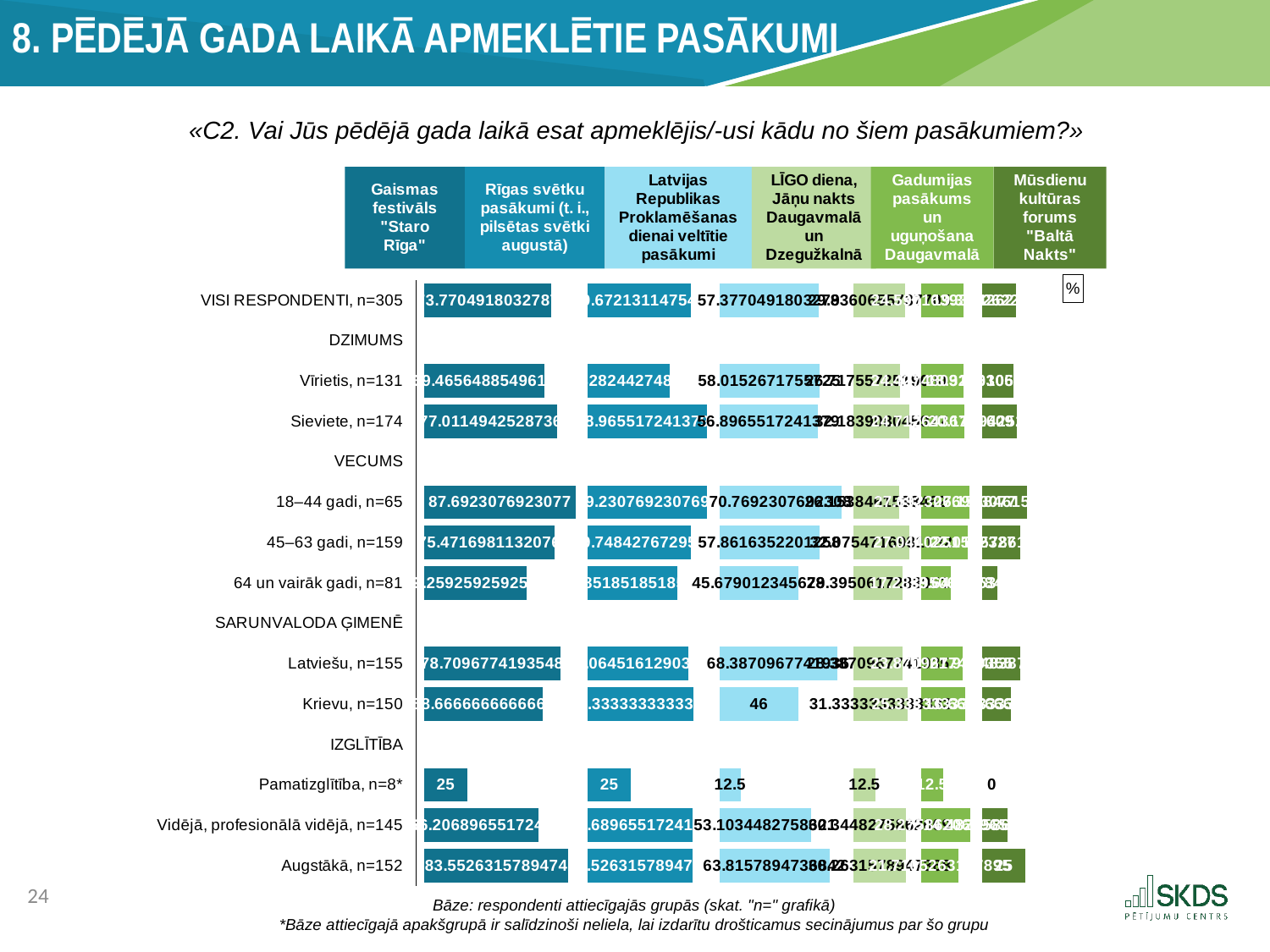
Which respondent group has the highest value for "Gaismas festivāls "Staro Rīga""? 18–44 gadi, n=65 What is the value for "Latvijas Republikas Proklamēšanas dienai veltītie pasākumi" in the "Krievu, n=150" row? 46 In the "Pamatizglītība, n=8*" row, which is larger: the value for "Gaismas festivāls "Staro Rīga"" or for "Latvijas Republikas Proklamēšanas dienai veltītie pasākumi"? Gaismas festivāls "Staro Rīga" How many respondent groups (rows with bars) are plotted in the chart? 11 Which respondent group has the lowest value for "Gaismas festivāls "Staro Rīga""? Pamatizglītība, n=8* What is the value for "Gaismas festivāls "Staro Rīga"" in the "Augstākā, n=152" row? 83.5526315789474 What is the value for "Mūsdienu kultūras forums "Baltā Nakts"" in the "Pamatizglītība, n=8*" row? 0 What is the value for "Gaismas festivāls "Staro Rīga"" in the "Pamatizglītība, n=8*" row? 25 What is the value for "Gaismas festivāls "Staro Rīga"" in the "18–44 gadi, n=65" row? 87.6923076923077 What kind of chart is shown on the slide? bar chart How many event series (column headers) does the chart show? 6 In the "Pamatizglītība, n=8*" row, what is the difference between the value for "Gaismas festivāls "Staro Rīga"" and the value for "LĪGO diena, Jāņu nakts Daugavmalā un Dzegužkalnā"? 12.5